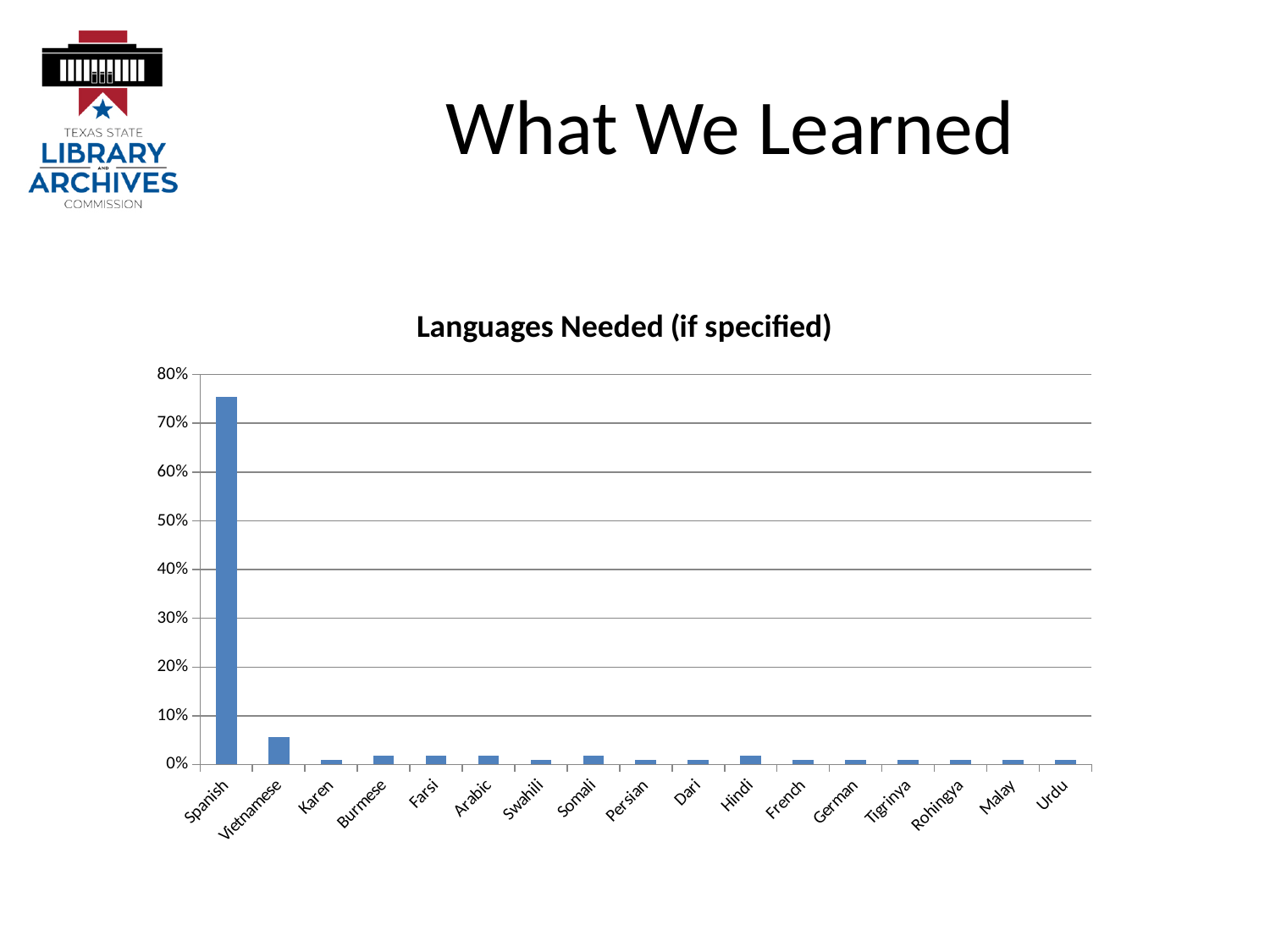
How many languages are shown on the x axis of the chart? 17 What is the title of the chart? Languages Needed (if specified) Is the value for Spanish greater or less than 70%? greater Which has a larger value, Vietnamese or Karen? Vietnamese Is the value for Vietnamese greater or less than 10%? less Is the value for Spanish greater or less than 80%? less Which has a larger value, Spanish or Vietnamese? Spanish What kind of chart is shown on the slide? bar chart What is the highest value shown on the y axis of the chart? 80% Which has a larger value, Vietnamese or Urdu? Vietnamese Which language has the highest value in the chart? Spanish